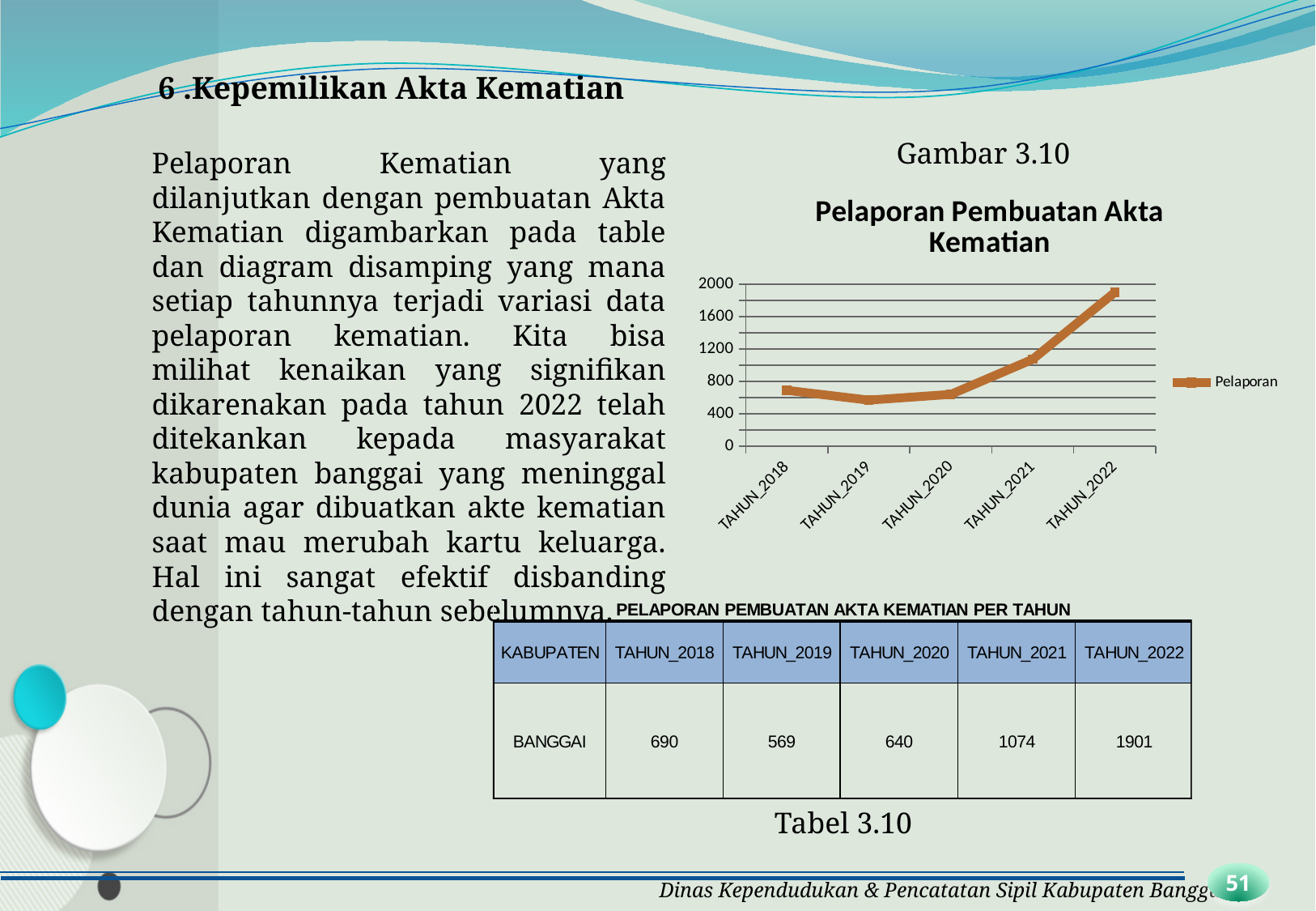
According to the table on the slide, what is the value for BANGGAI in TAHUN_2018? 690 Which year has the highest value in the "Pelaporan Pembuatan Akta Kematian" chart? TAHUN_2022 According to the table on the slide, what is the value for BANGGAI in TAHUN_2022? 1901 Using the values printed in the table, what is the difference between TAHUN_2022 and TAHUN_2021? 827 How many years are plotted on the x axis of the "Pelaporan Pembuatan Akta Kematian" chart? 5 How many series does the legend of the "Pelaporan Pembuatan Akta Kematian" chart list? 1 Is the value for TAHUN_2019 in the chart greater or less than 800? less What type of chart is shown under the title "Pelaporan Pembuatan Akta Kematian"? line chart Which is larger in the chart, the value for TAHUN_2021 or the value for TAHUN_2020? TAHUN_2021 What is the name of the series shown in the legend of the chart? Pelaporan Is the value for TAHUN_2022 in the chart greater or less than 1600? greater Which year has the lowest value in the "Pelaporan Pembuatan Akta Kematian" chart? TAHUN_2019